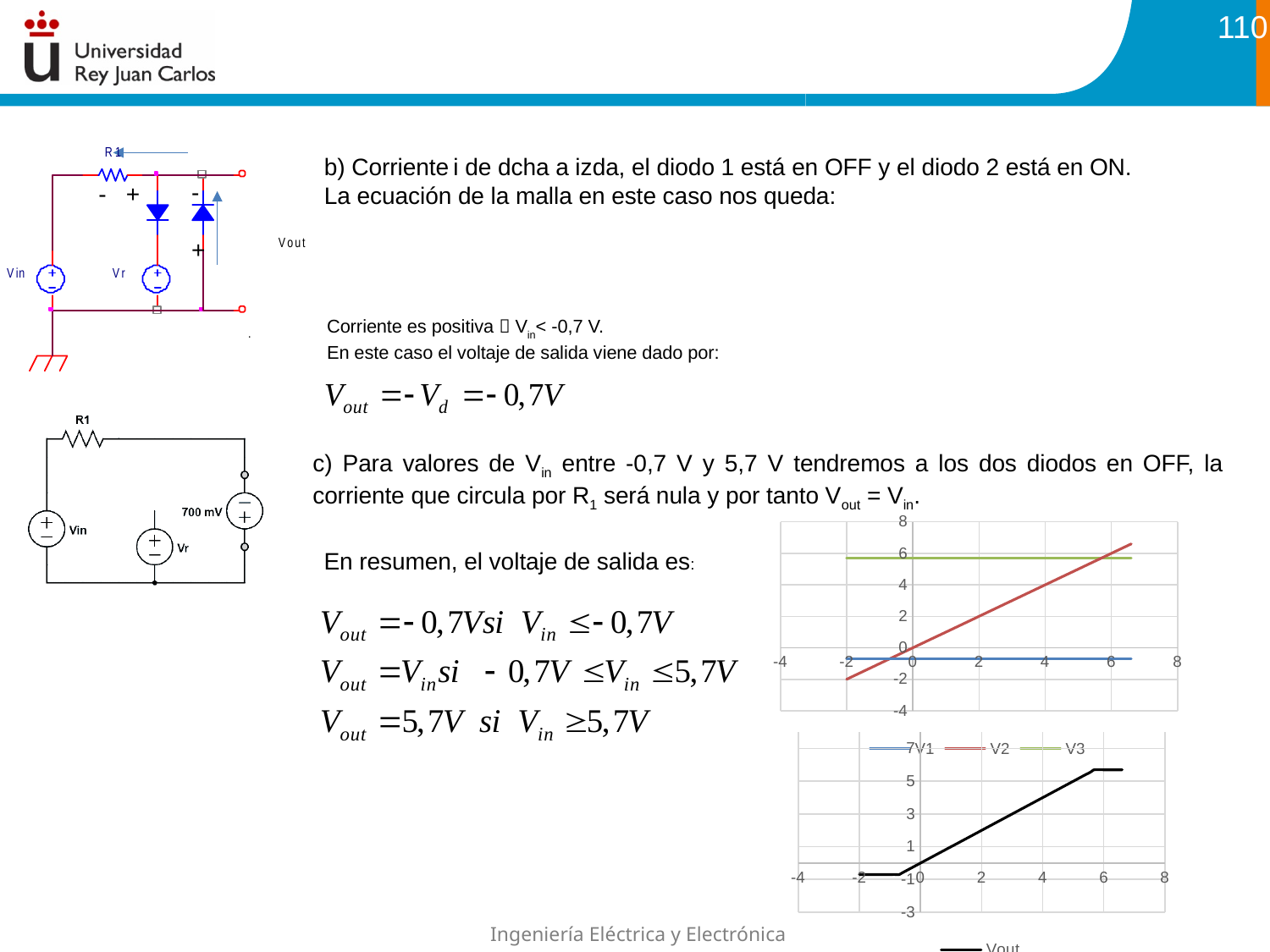
In the bottom chart, is the value of Vout at x = 6 greater or less than 5? greater What is the legend entry of the bottom chart? Vout What kind of chart is the top chart on the right (with legend V1, V2, V3)? line chart What kind of chart is the bottom chart on the right (with legend Vout)? line chart How many series does the legend of the top chart list? 3 In the top chart, does the red diagonal line rise or fall as x increases? rise What are the legend entries of the top chart? V1, V2, V3 In the top chart, is the value of the blue horizontal line greater or less than 2? less In the top chart, is the value of the green horizontal line greater or less than 4? greater In the bottom chart, does Vout rise or fall as x goes from 0 to 4? rise How many series does the legend of the bottom chart list? 1